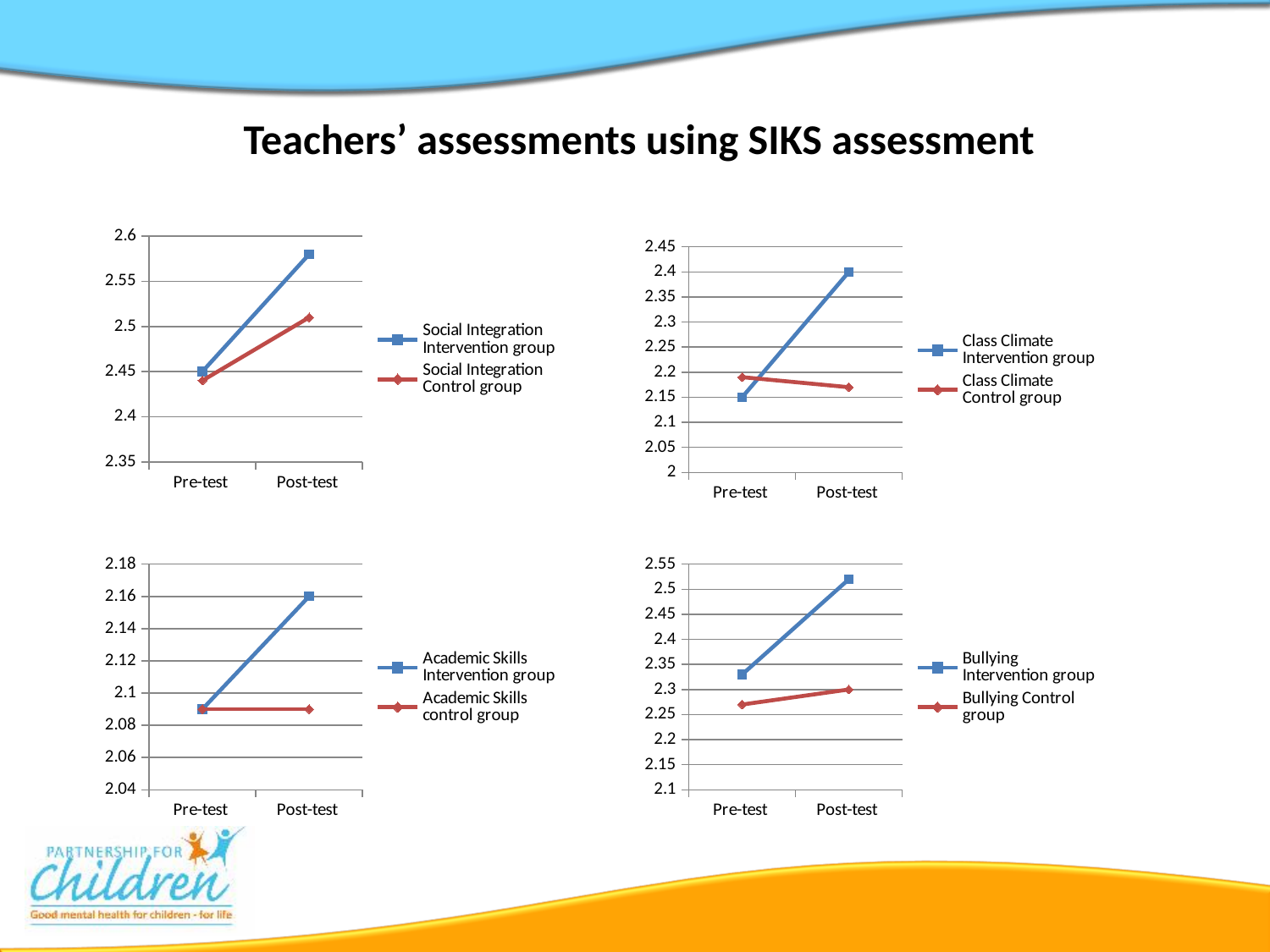
How many categories are shown on the x axis of the bottom-left chart? 2 What is the title of the slide? Teachers' assessments using SIKS assessment In the bottom-right chart, is the Post-test value for the Bullying Intervention group greater or less than 2.45? greater What type of chart is the top-left chart on the slide? Line chart In the top-right chart, is the Pre-test value for the Class Climate Intervention group greater or less than 2.2? less In the top-right chart, does the Class Climate Intervention group rise or fall from Pre-test to Post-test? Rise In the bottom-left chart, is the Post-test value for the Academic Skills Intervention group greater or less than 2.14? greater How many series does the legend of the top-right chart list? 2 In the top-left chart, which group has the higher Post-test value, the Social Integration Intervention group or the Social Integration Control group? Social Integration Intervention group In the bottom-right chart, which group has the higher Pre-test value, the Bullying Intervention group or the Bullying Control group? Bullying Intervention group